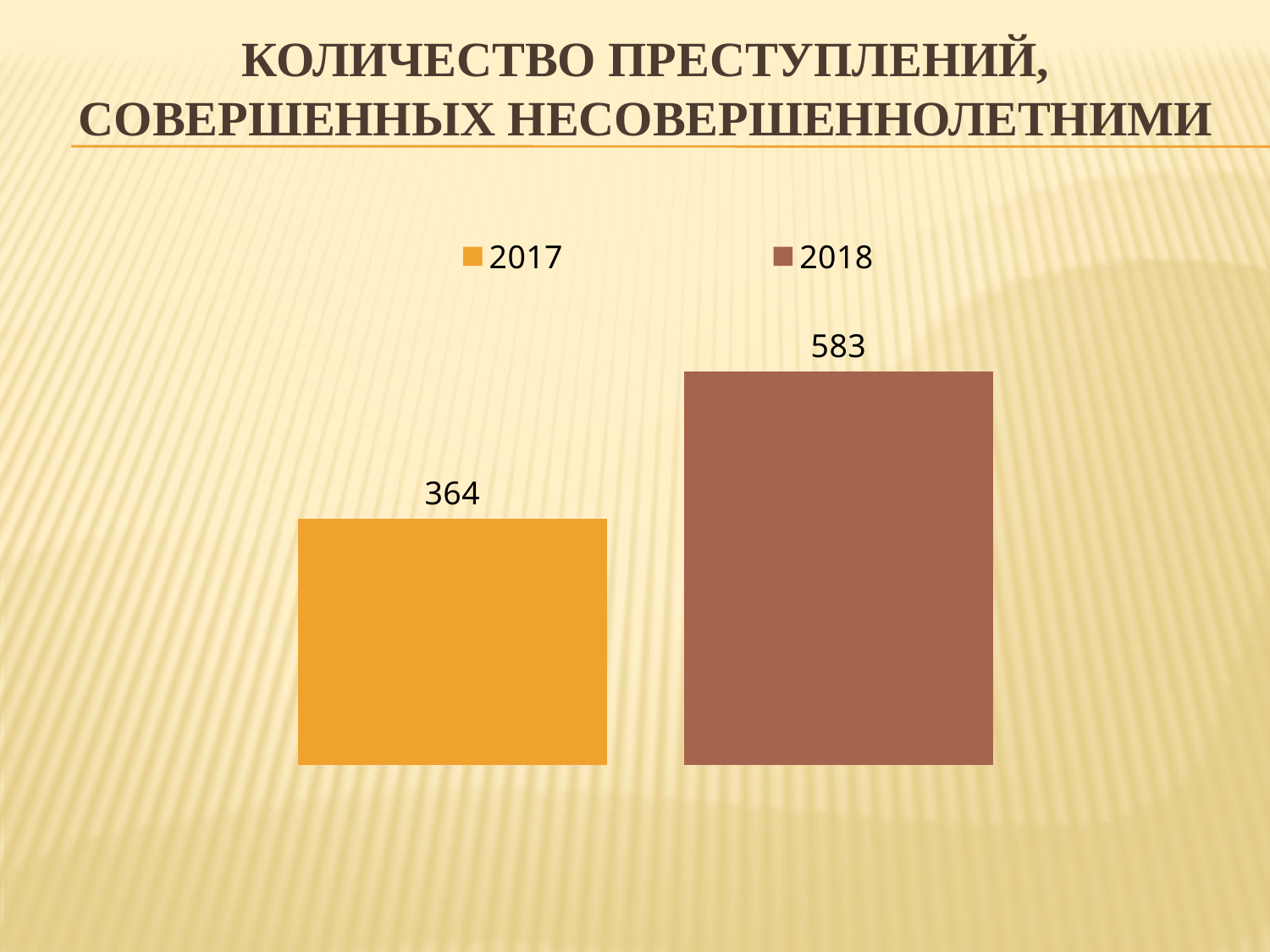
Do the values rise or fall from 2017 to 2018? Rise Which year has the higher value? 2018 What is the total of the two values shown? 947 What kind of chart is shown on the slide? Bar chart Which year has the lower value? 2017 What is the value for 2017? 364 What is the difference between the values for 2018 and 2017? 219 Is the value for 2018 larger than the value for 2017? Yes How many entries does the legend list? 2 What colour is the bar for 2018? Brown What is the value for 2018? 583 How many bars are plotted on the chart? 2